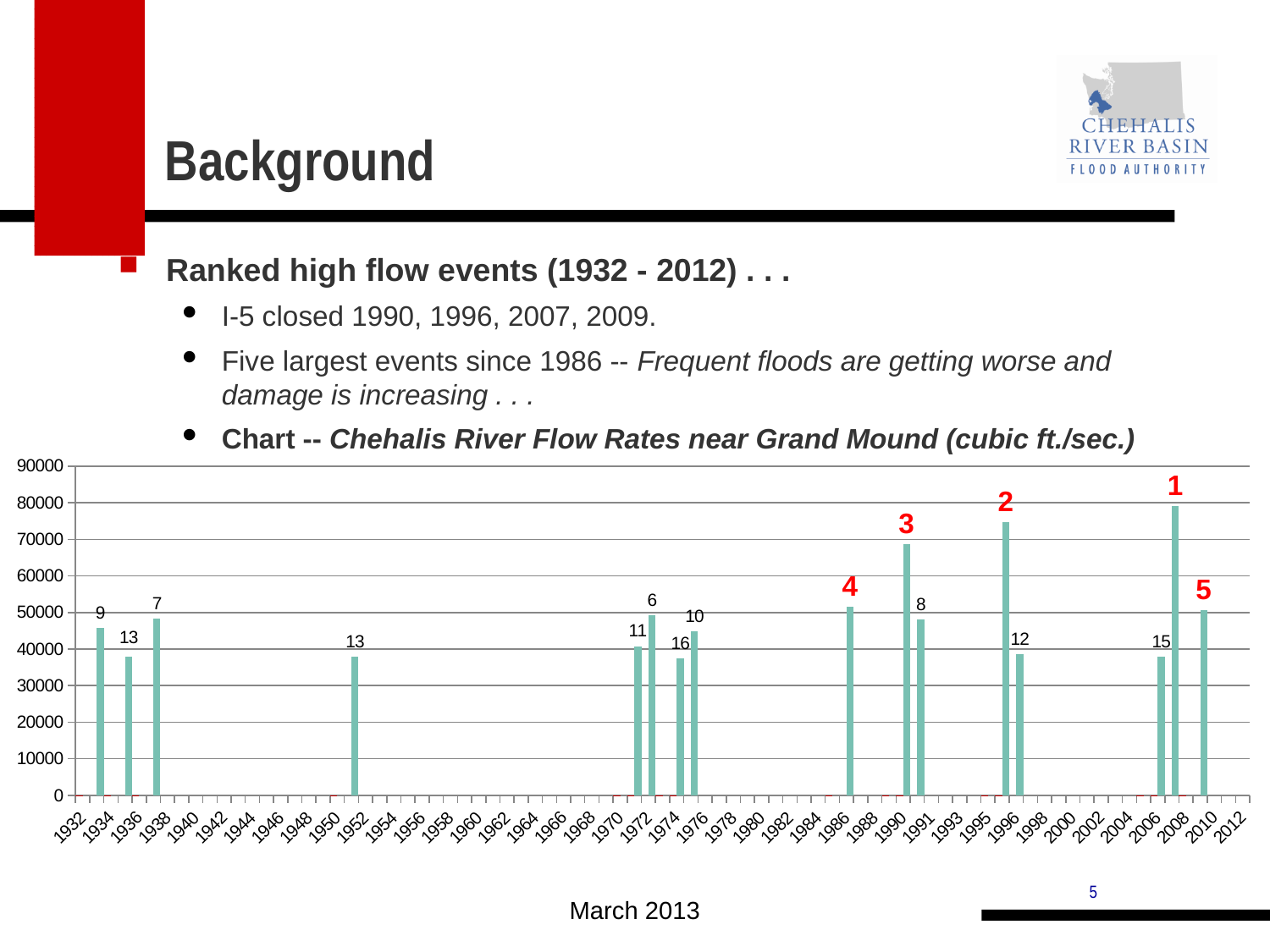
Is the value of the bar labeled 16 greater or less than 40000? less What kind of chart is shown on the slide? bar chart Which is larger, the bar labeled 2 or the bar labeled 3? the bar labeled 2 Is the value of the bar labeled 7 greater or less than 50000? less Is the value of the bar labeled 2 greater or less than 70000? greater How many bars in the chart have red rank labels? 5 Which rank label marks the highest bar in the chart? 1 Which rank label marks the lowest bar in the chart? 16 What is the title of the chart on the slide? Chehalis River Flow Rates near Grand Mound (cubic ft./sec.) How many bars are plotted in the chart? 16